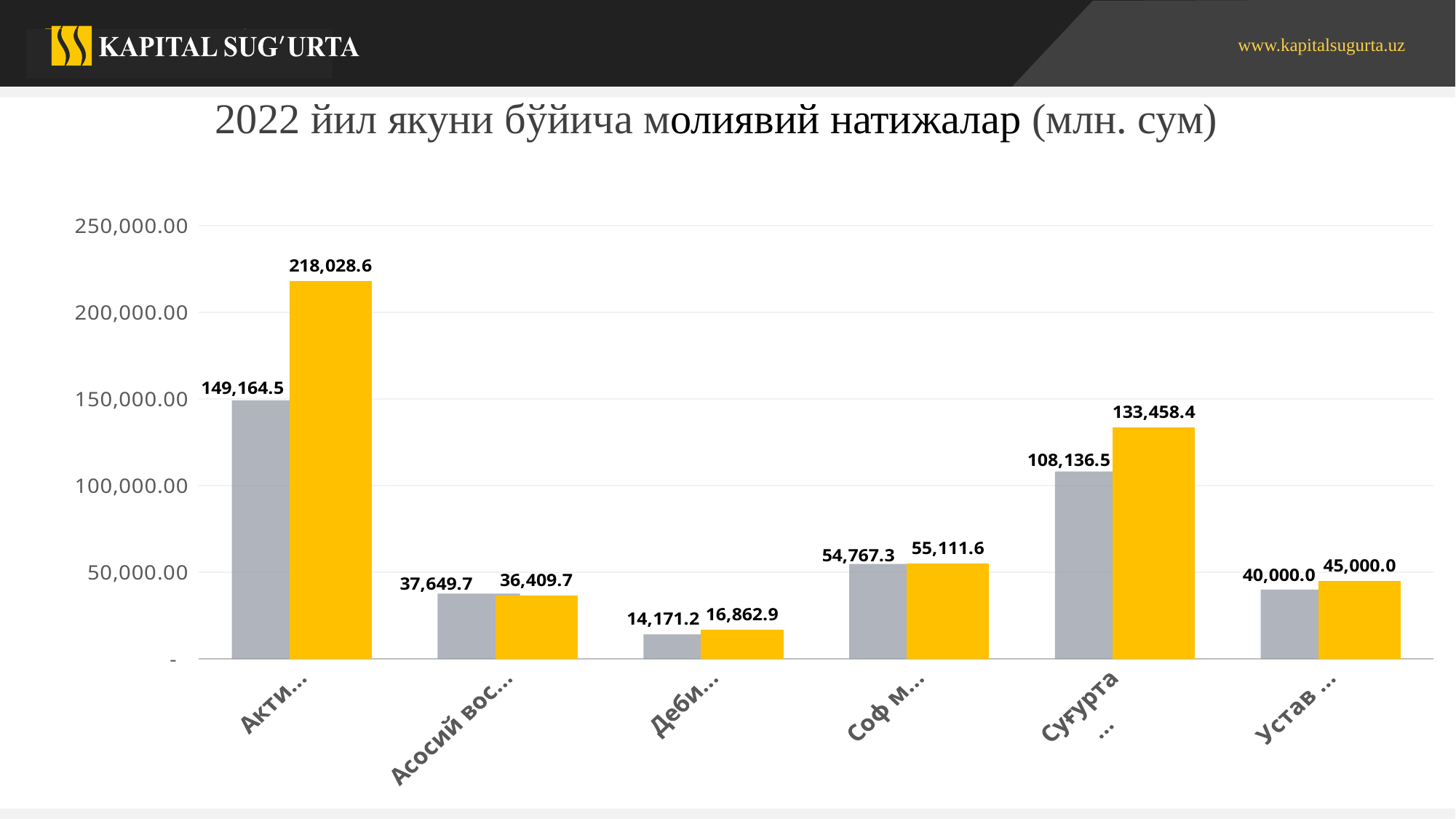
Which category has the lowest grey bar? Деби... (the third category) What type of chart is shown on the slide? bar chart What is the value of the grey bar for the first category (Акти...)? 149,164.5 What is the value of the yellow bar for the fifth category (Суғурта ...)? 133,458.4 What is the difference between the yellow and grey bars for the last category (Устав ...)? 5,000.0 How many categories are shown along the x axis of the chart? 6 For the second category (Асосий вос...), which bar is larger, the grey one or the yellow one? the grey one (37,649.7) What is the value of the yellow bar for the first category (Акти...)? 218,028.6 What is the title of the chart? 2022 йил якуни бўйича молиявий натижалар (млн. сум) What is the difference between the yellow and grey bars for the first category (Акти...)? 68,864.1 What is the value of the grey bar for the third category (Деби...)? 14,171.2 Which category has the highest yellow bar? Акти... (the first category)